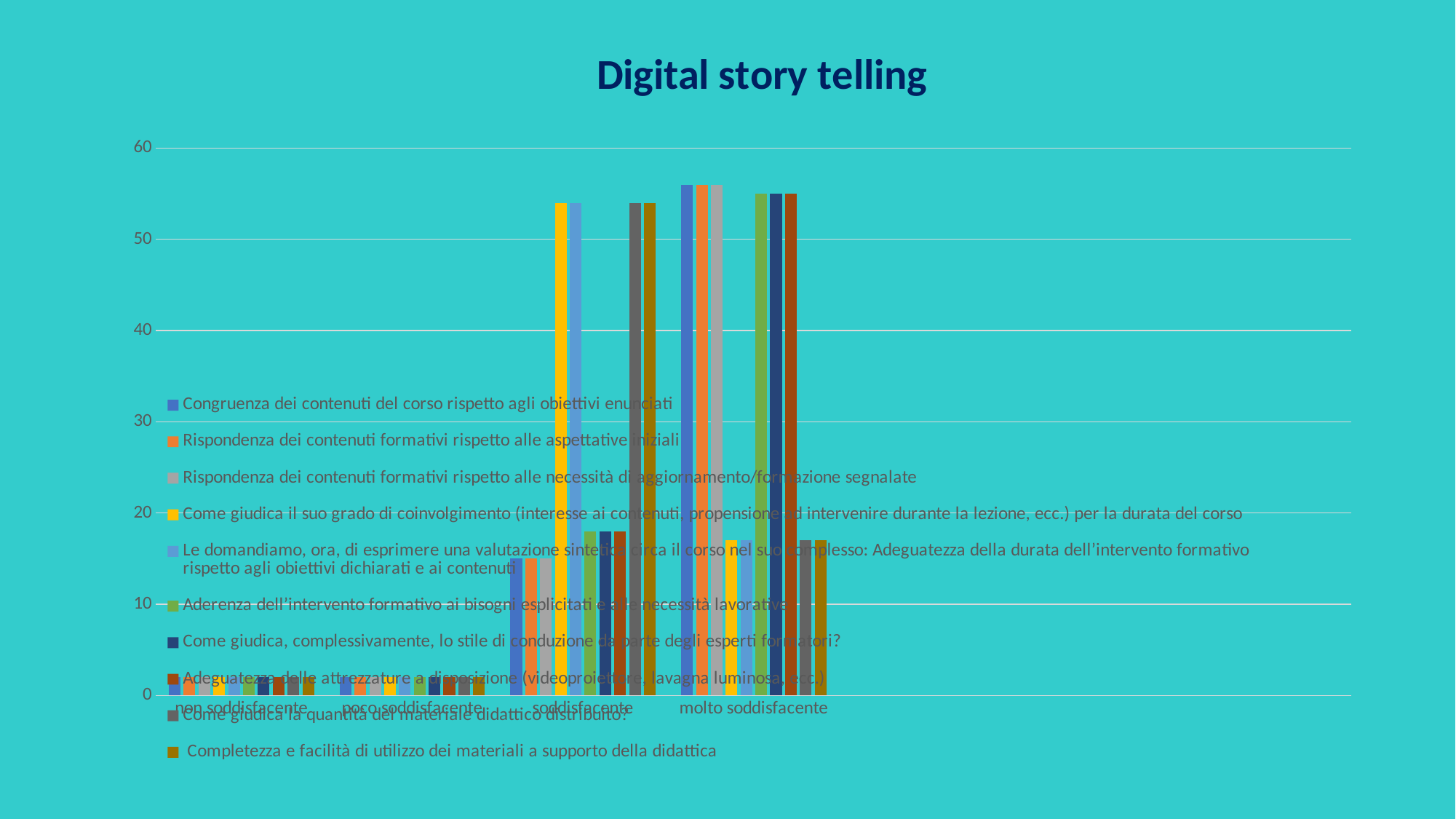
For the series 'Congruenza dei contenuti del corso rispetto agli obiettivi enunciati', which is larger: the value for 'soddisfacente' or for 'molto soddisfacente'? molto soddisfacente For the series 'Congruenza dei contenuti del corso rispetto agli obiettivi enunciati', do the values rise or fall from 'non soddisfacente' to 'molto soddisfacente'? rise What kind of chart is shown on the slide? bar chart Is the value for 'Come giudica il suo grado di coinvolgimento (interesse ai contenuti, propensione ad intervenire durante la lezione, ecc.) per la durata del corso' in the 'molto soddisfacente' category greater or less than 20? less Is the value for 'Congruenza dei contenuti del corso rispetto agli obiettivi enunciati' in the 'molto soddisfacente' category greater or less than 50? greater Is the value for 'Come giudica la quantità del materiale didattico distribuito?' in the 'soddisfacente' category greater or less than 50? greater For the series 'Congruenza dei contenuti del corso rispetto agli obiettivi enunciati', which category has the highest value? molto soddisfacente How many series does the chart's legend list? 10 For the series 'Come giudica il suo grado di coinvolgimento (interesse ai contenuti, propensione ad intervenire durante la lezione, ecc.) per la durata del corso', which category has the highest value? soddisfacente What is the title of the chart? Digital story telling How many categories are shown on the x axis of the chart? 4